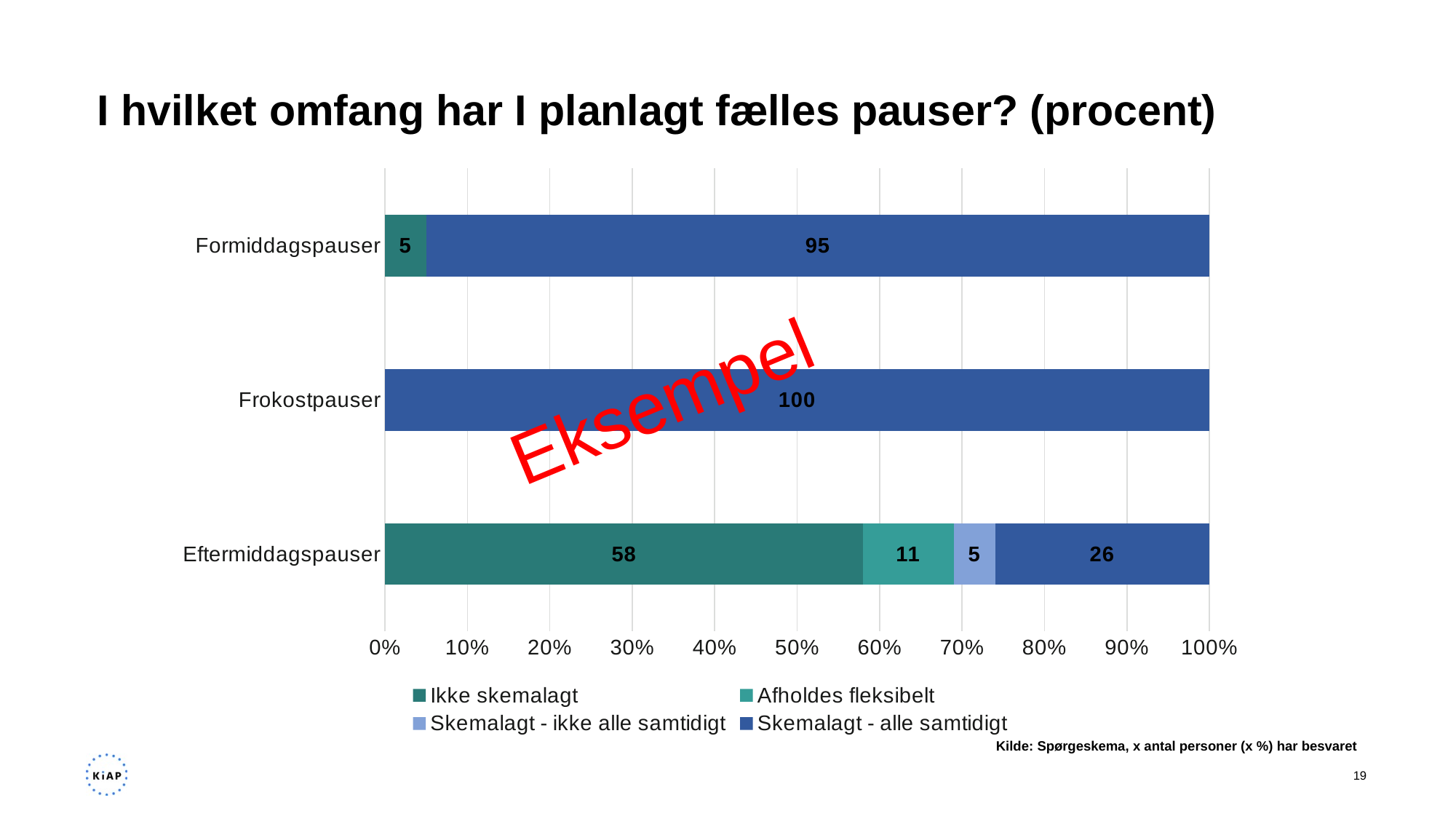
What is the value for 'Ikke skemalagt' in the Eftermiddagspauser bar? 58 Which is larger in the Eftermiddagspauser bar: 'Afholdes fleksibelt' or 'Skemalagt - alle samtidigt'? Skemalagt - alle samtidigt What is the difference between the 'Skemalagt - alle samtidigt' values for Formiddagspauser and Eftermiddagspauser? 69 How many categories are shown on the y axis? 3 What kind of chart is shown on the slide? Stacked bar chart Which category has the highest value for 'Ikke skemalagt'? Eftermiddagspauser What is the value for 'Skemalagt - alle samtidigt' in the Formiddagspauser bar? 95 How many series does the legend list? 4 What is the value for 'Skemalagt - alle samtidigt' in the Frokostpauser bar? 100 Which category has the lowest value for 'Skemalagt - alle samtidigt'? Eftermiddagspauser What is the title of the chart? I hvilket omfang har I planlagt fælles pauser? (procent) What is the value for 'Afholdes fleksibelt' in the Eftermiddagspauser bar? 11